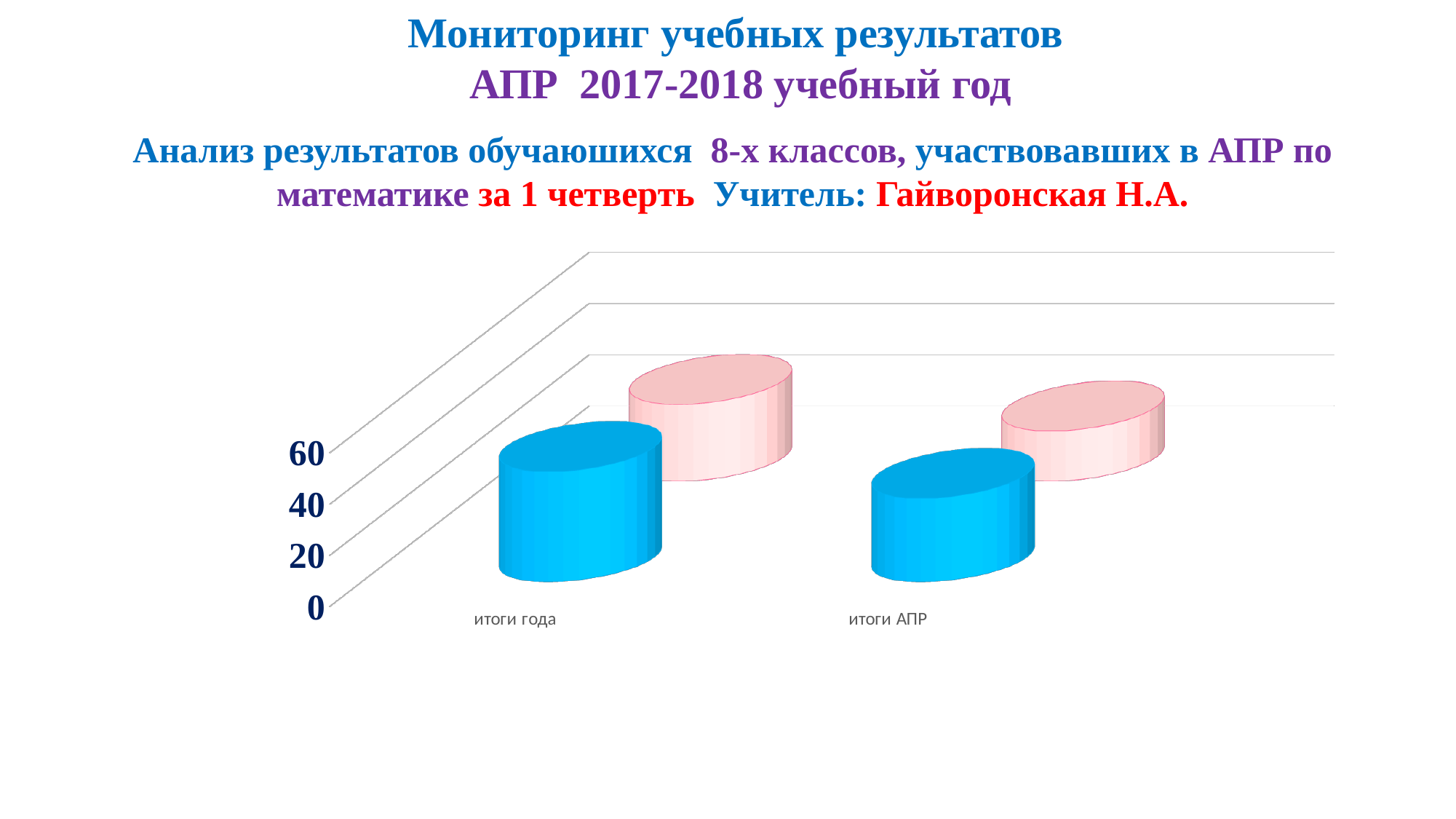
How many categories are shown on the x axis of the chart? 2 How many bars are plotted in the chart in total? 4 Is the blue bar for итоги АПР greater or less than 20? greater What kind of chart is shown on the slide? bar chart For the blue series, which category has the lowest value? итоги АПР What is the highest value labelled on the vertical axis of the chart? 60 For the pink series, which category has the higher value: итоги года or итоги АПР? итоги года What are the two category labels on the x axis of the chart? итоги года, итоги АПР For the blue series, which category has the higher value: итоги года or итоги АПР? итоги года Do the values of the pink series rise or fall from итоги года to итоги АПР? fall Do the values of the blue series rise or fall from итоги года to итоги АПР? fall